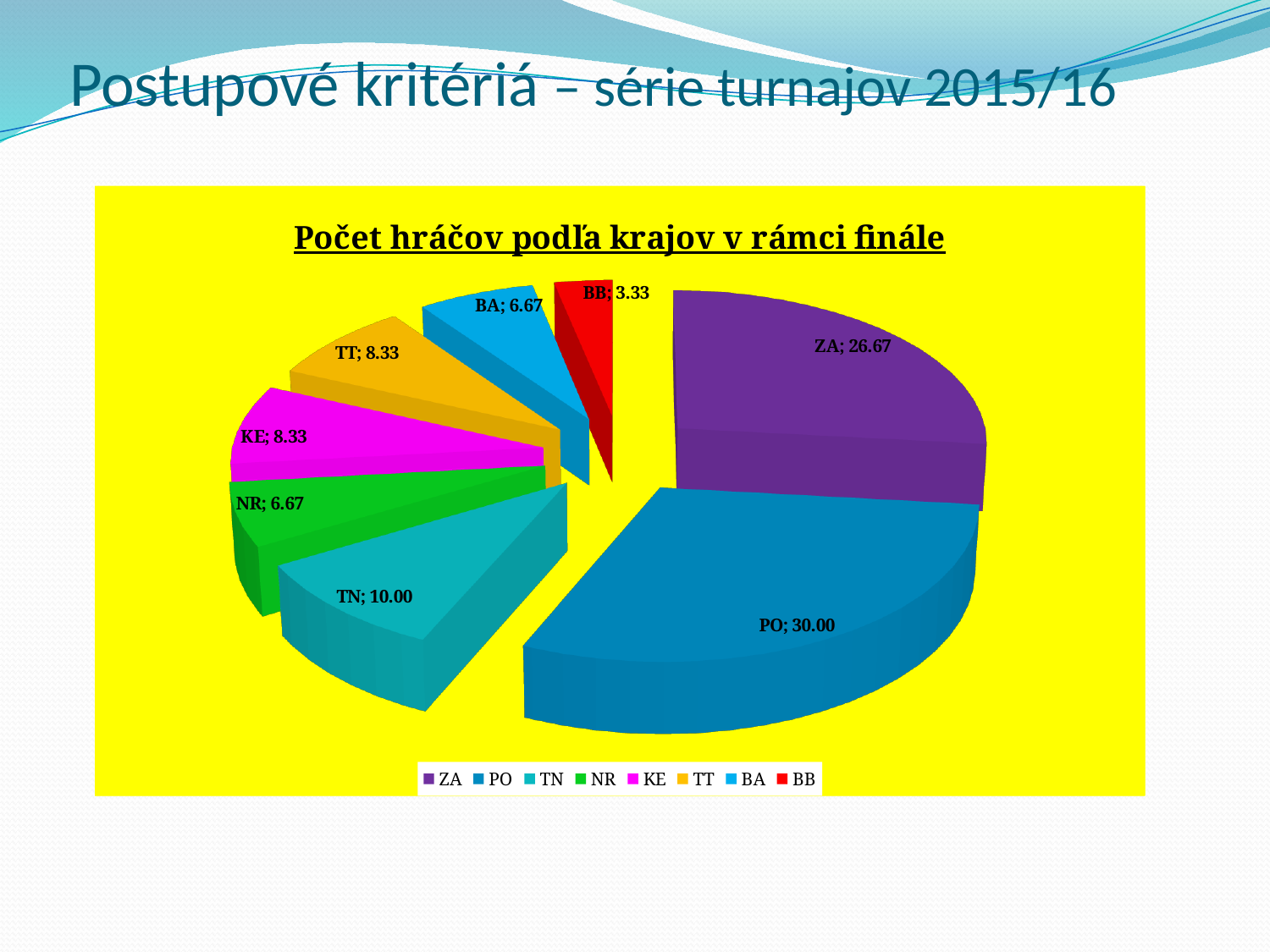
How many slices does the pie chart have? 8 Which category has the smallest slice in the pie chart? BB What is the value shown for PO in the pie chart? 30.00 Which category has the largest slice in the pie chart? PO What kind of chart is shown on the slide? Pie chart What is the value shown for BB in the pie chart? 3.33 What is the value shown for ZA in the pie chart? 26.67 Which is larger, the value for TN or the value for KE? TN What is the title of the chart? Počet hráčov podľa krajov v rámci finále How many entries does the legend list? 8 What is the value shown for TN in the pie chart? 10.00 What is the difference between the values for PO and ZA? 3.33